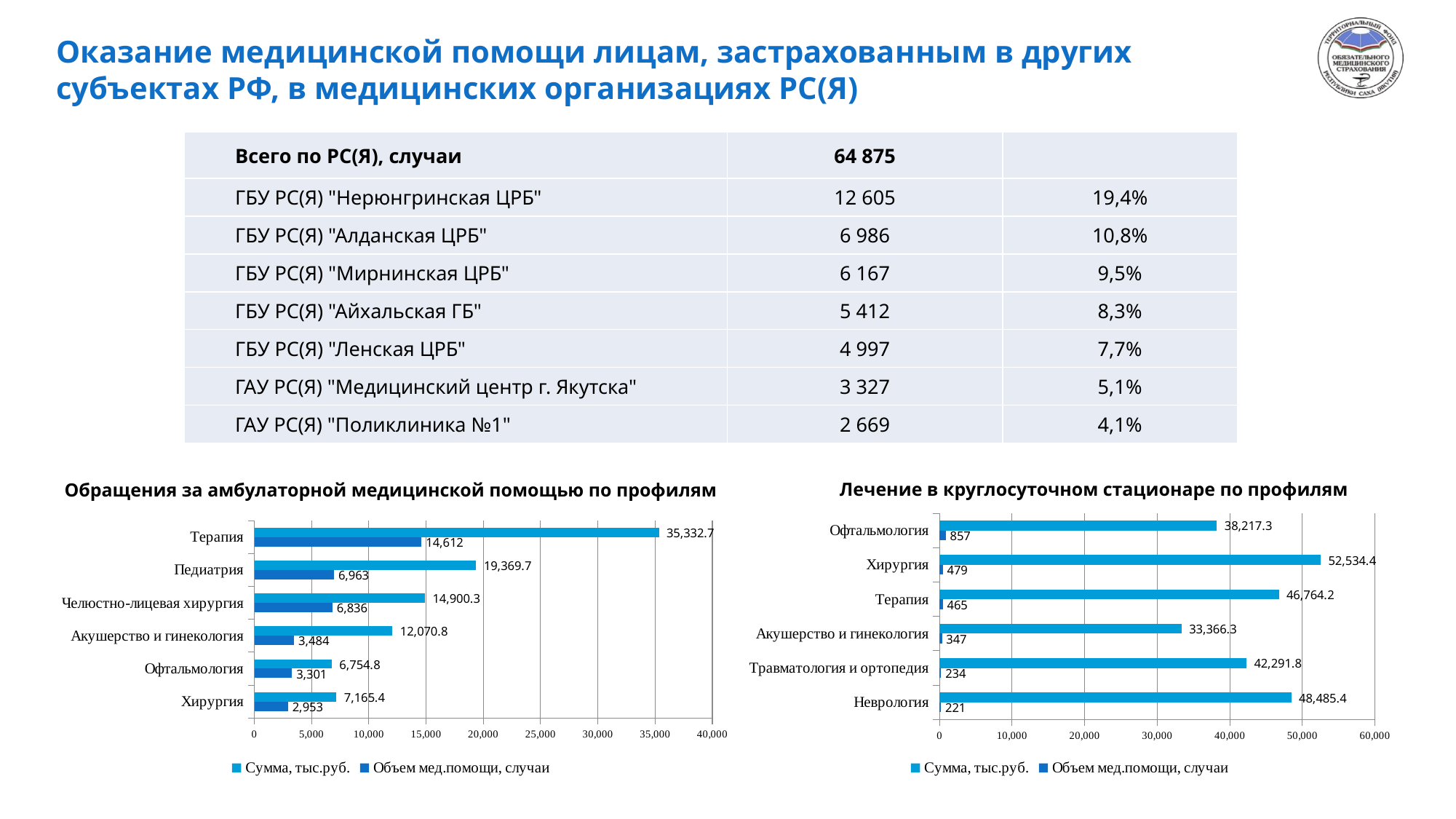
In the chart "Обращения за амбулаторной медицинской помощью по профилям", how many series does the legend list? 2 In the chart "Лечение в круглосуточном стационаре по профилям", which is larger in "Сумма, тыс.руб.": Терапия or Травматология и ортопедия? Терапия In the chart "Обращения за амбулаторной медицинской помощью по профилям", what is the value of "Объем мед.помощи, случаи" for Педиатрия? 6,963 In the chart "Лечение в круглосуточном стационаре по профилям", what is the difference in "Объем мед.помощи, случаи" between Офтальмология and Хирургия? 378 In the chart "Обращения за амбулаторной медицинской помощью по профилям", which category has the lowest "Объем мед.помощи, случаи"? Хирургия In the chart "Лечение в круглосуточном стационаре по профилям", what is the value of "Объем мед.помощи, случаи" for Неврология? 221 In the chart "Обращения за амбулаторной медицинской помощью по профилям", how many categories are shown? 6 What type of chart is "Лечение в круглосуточном стационаре по профилям"? Bar chart In the chart "Обращения за амбулаторной медицинской помощью по профилям", what is the difference in "Сумма, тыс.руб." between Педиатрия and Челюстно-лицевая хирургия? 4,469.4 In the chart "Лечение в круглосуточном стационаре по профилям", which category has the highest "Сумма, тыс.руб."? Хирургия In the chart "Лечение в круглосуточном стационаре по профилям", what is the value of "Сумма, тыс.руб." for Хирургия? 52,534.4 In the chart "Обращения за амбулаторной медицинской помощью по профилям", what is the value of "Сумма, тыс.руб." for Терапия? 35,332.7